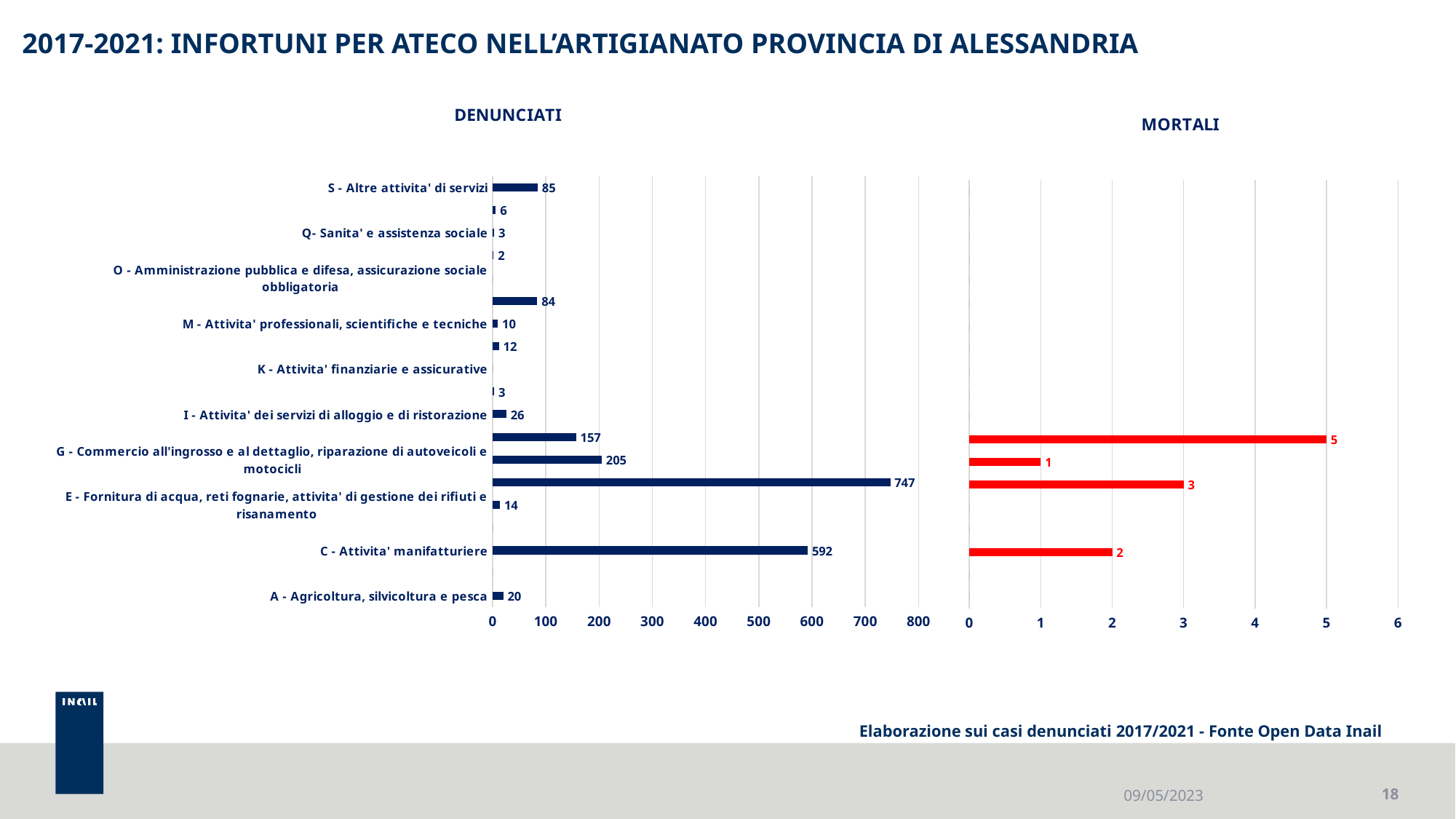
In the DENUNCIATI chart, what is the value for A - Agricoltura, silvicoltura e pesca? 20 In the DENUNCIATI chart, what is the value for S - Altre attivita' di servizi? 85 In the DENUNCIATI chart, what is the value for C - Attivita' manifatturiere? 592 In the DENUNCIATI chart, what is the value for G - Commercio all'ingrosso e al dettaglio, riparazione di autoveicoli e motocicli? 205 In the DENUNCIATI chart, which is larger: the value for S - Altre attivita' di servizi or the value for A - Agricoltura, silvicoltura e pesca? S - Altre attivita' di servizi In the MORTALI chart, what is the value for G - Commercio all'ingrosso e al dettaglio, riparazione di autoveicoli e motocicli? 1 What is the largest value shown in the DENUNCIATI chart? 747 In the DENUNCIATI chart, what is the difference between the values for C - Attivita' manifatturiere and G - Commercio all'ingrosso e al dettaglio? 387 What kind of chart is the MORTALI chart? Bar chart In the DENUNCIATI chart, what is the value for I - Attivita' dei servizi di alloggio e di ristorazione? 26 In the MORTALI chart, what is the value for C - Attivita' manifatturiere? 2 What is the largest value shown in the MORTALI chart? 5